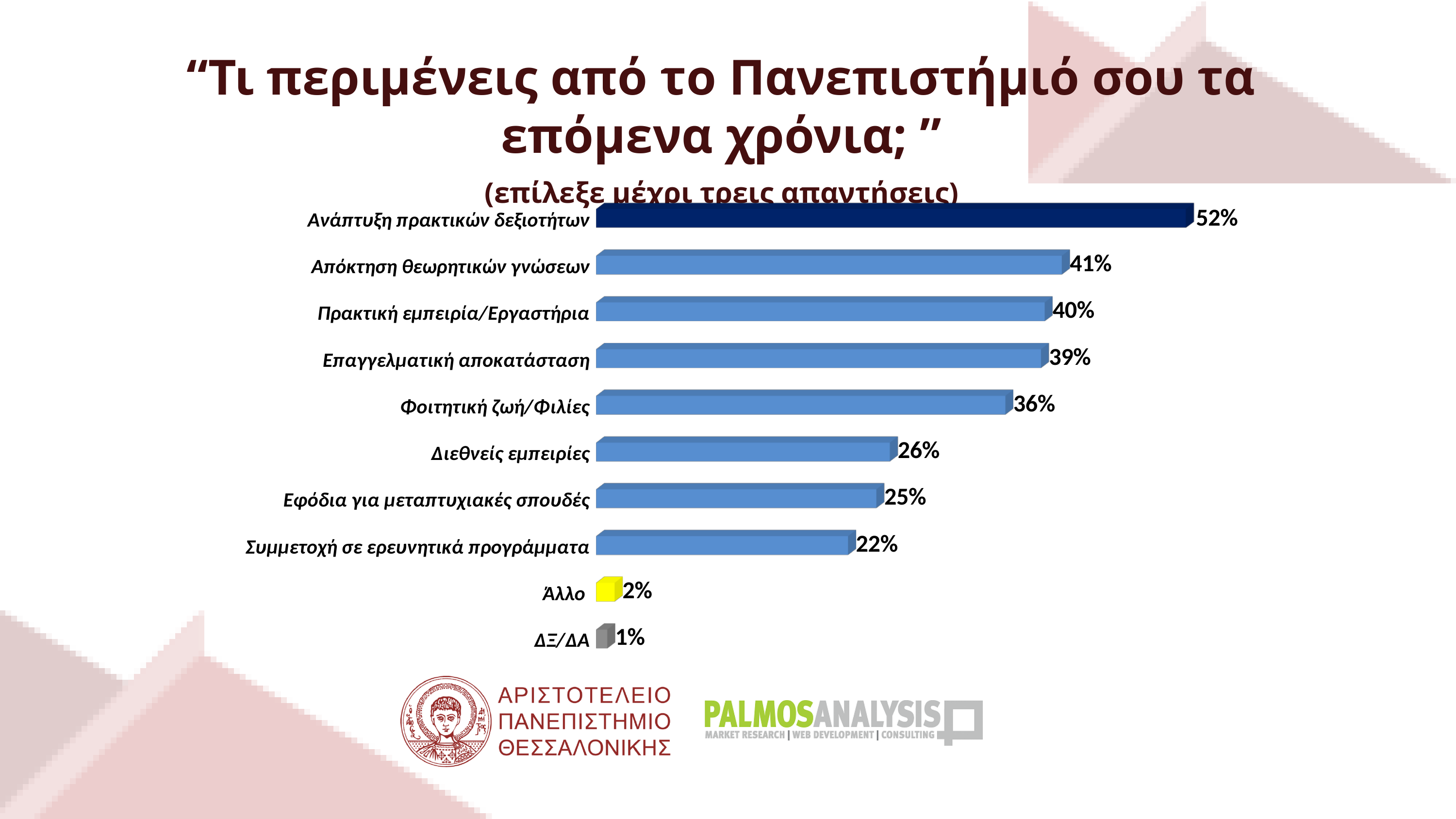
What is the difference between Ανάπτυξη πρακτικών δεξιοτήτων and Απόκτηση θεωρητικών γνώσεων? 11% What is the value for Ανάπτυξη πρακτικών δεξιοτήτων? 52% Which category has the highest value? Ανάπτυξη πρακτικών δεξιοτήτων Which category's bar is coloured yellow? Άλλο Which is larger, Επαγγελματική αποκατάσταση or Εφόδια για μεταπτυχιακές σπουδές? Επαγγελματική αποκατάσταση Which category has the lowest value? ΔΞ/ΔΑ What is the value for Φοιτητική ζωή/Φιλίες? 36% What is the difference between Διεθνείς εμπειρίες and Συμμετοχή σε ερευνητικά προγράμματα? 4% What is the value for ΔΞ/ΔΑ? 1% What kind of chart is shown on the slide? Bar chart How many categories are shown in the chart? 10 What is the value for Συμμετοχή σε ερευνητικά προγράμματα? 22%